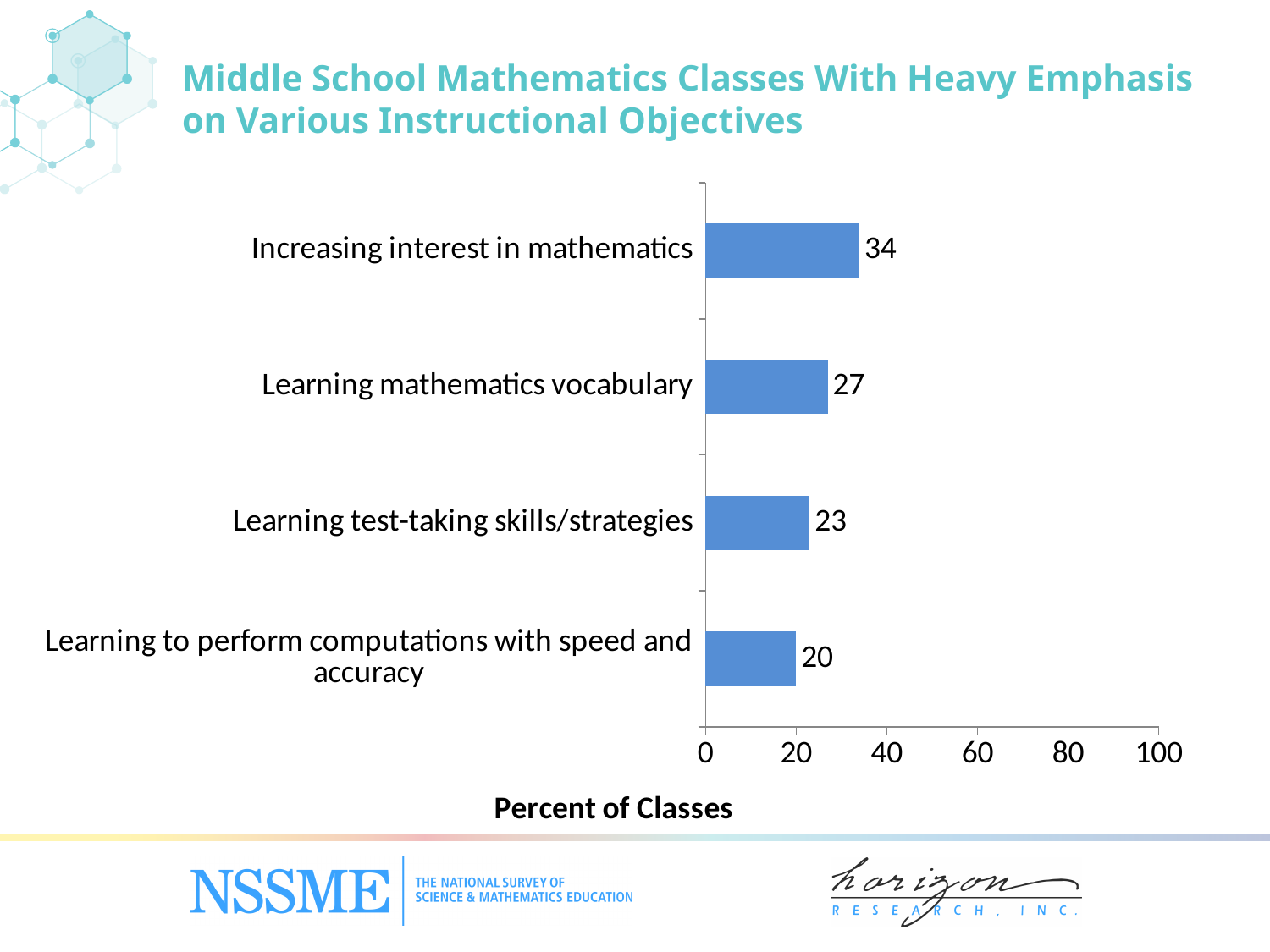
How many instructional objectives are shown in the chart? 4 What is the value for learning to perform computations with speed and accuracy? 20 Which instructional objective has the highest percent of classes? Increasing interest in mathematics What kind of chart is shown on the slide? Bar chart What is the label of the horizontal axis? Percent of Classes What percent of classes place heavy emphasis on increasing interest in mathematics? 34 Is the value for increasing interest in mathematics greater or less than 40? less What is the value for learning test-taking skills/strategies? 23 What is the value for learning mathematics vocabulary? 27 What is the difference between the values for increasing interest in mathematics and learning to perform computations with speed and accuracy? 14 Which instructional objective has the lowest percent of classes? Learning to perform computations with speed and accuracy Which is larger: the value for learning mathematics vocabulary or learning test-taking skills/strategies? Learning mathematics vocabulary